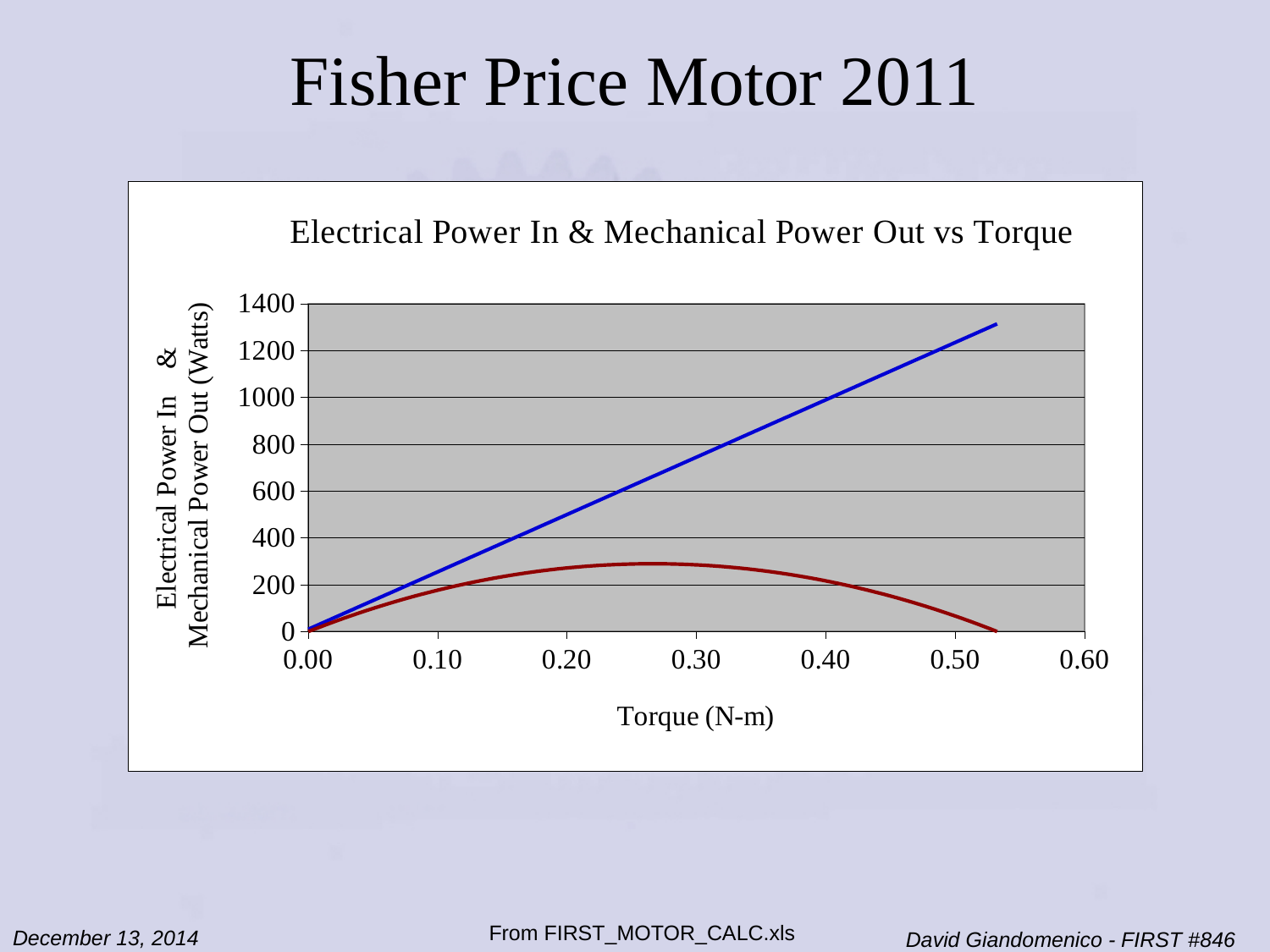
At a torque of 0.30, which line has the higher value, the blue line or the dark red curve? the blue line What is the title of the chart? Electrical Power In & Mechanical Power Out vs Torque What kind of chart is shown on the slide? line chart How many lines are plotted on the chart? 2 Is the value of the blue line at a torque of 0.20 greater or less than 600? less What is the highest value shown on the y axis? 1400 Is the peak value of the dark red curve greater or less than 400? less What is the label of the x axis? Torque (N-m) Is the value of the blue line at a torque of 0.30 greater or less than 800? less Does the blue line rise or fall as torque increases? rises